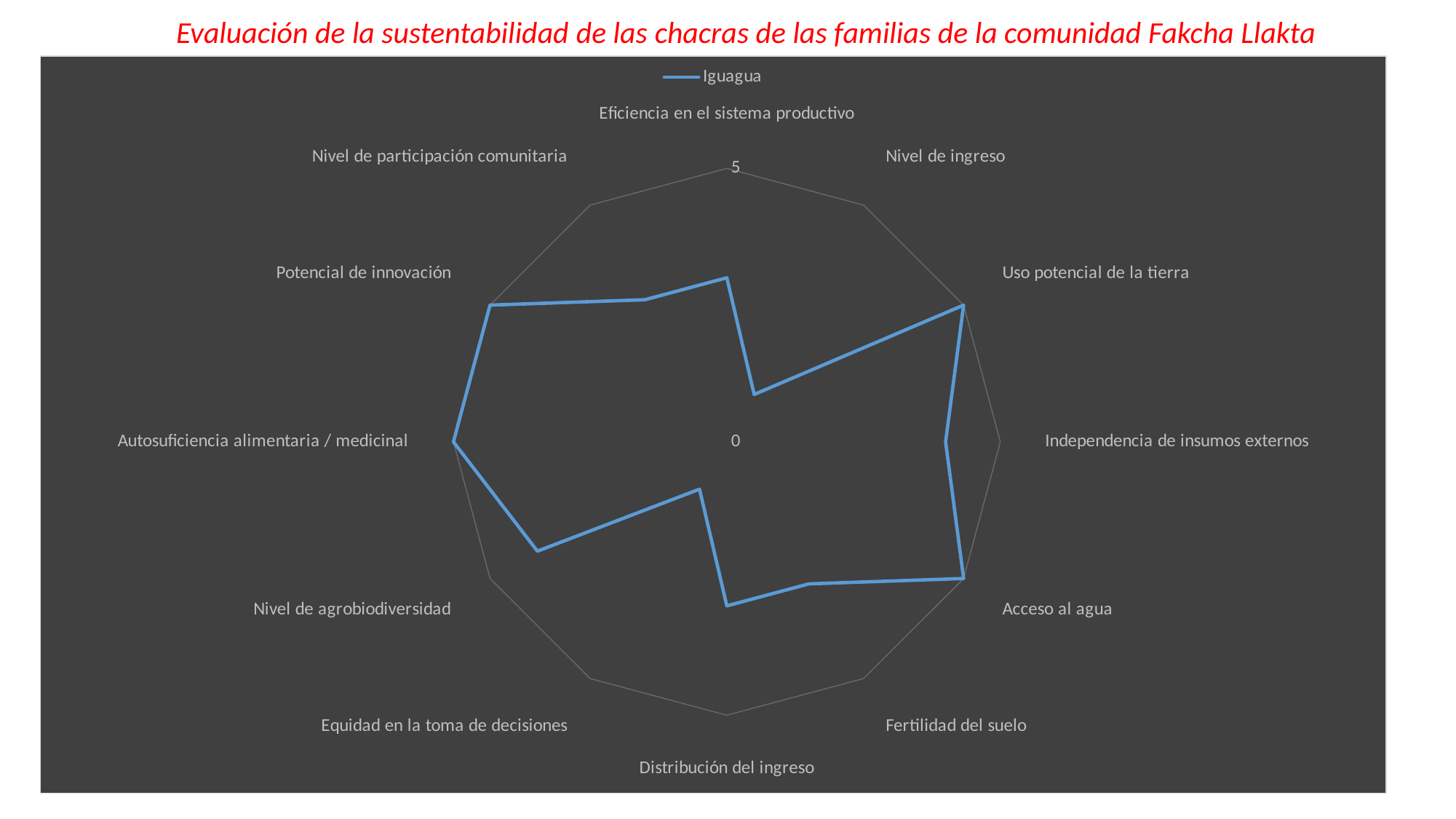
Which is larger, the value for Autosuficiencia alimentaria / medicinal or the value for Distribución del ingreso? Autosuficiencia alimentaria / medicinal Which is larger, the value for Uso potencial de la tierra or the value for Nivel de ingreso? Uso potencial de la tierra Is the value for Nivel de ingreso greater or less than 5? less What kind of chart is shown on the slide? Radar chart How many series does the legend list? 1 Which is larger, the value for Potencial de innovación or the value for Nivel de participación comunitaria? Potencial de innovación What is the maximum value shown on the radar chart's axis scale? 5 Is the value for Fertilidad del suelo greater or less than 5? less How many categories (axes) does the radar chart have? 12 What is the name of the series shown in the legend? Iguagua What is the title of the slide above the chart? Evaluación de la sustentabilidad de las chacras de las familias de la comunidad Fakcha Llakta